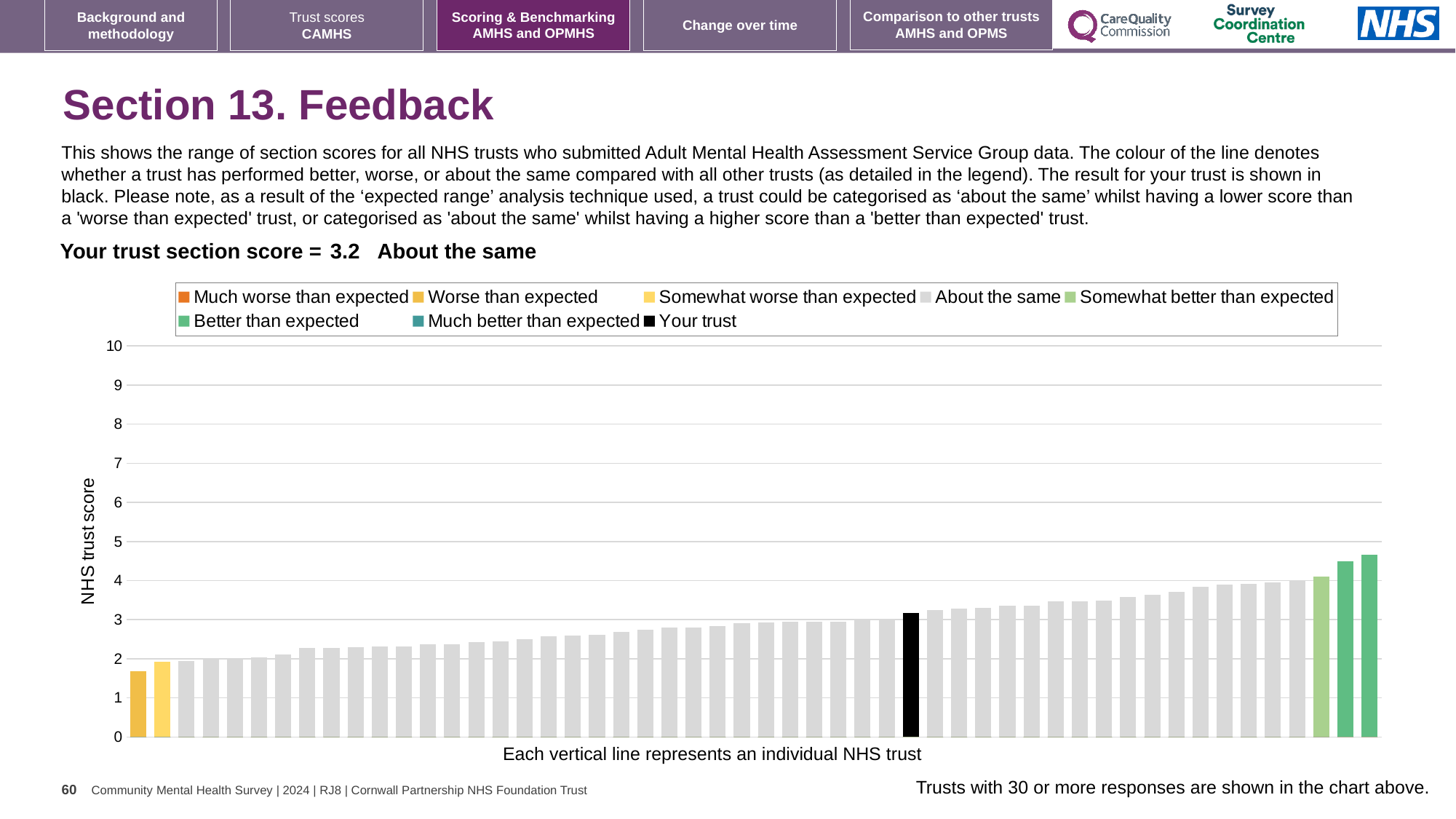
What kind of chart is shown on the slide? bar chart Is the value of the shortest bar greater or less than 2? less Is the value for your trust greater or less than 4? less Is the value of the tallest bar greater or less than 4? greater What is the section score for your trust? 3.2 What is the label on the vertical axis of the chart? NHS trust score Do the bar values rise or fall from left to right along the x axis? rise How many entries does the chart legend list? 8 Which category is your trust's section score placed in? About the same What colour is the bar representing your trust? black What is the highest value shown on the vertical axis? 10